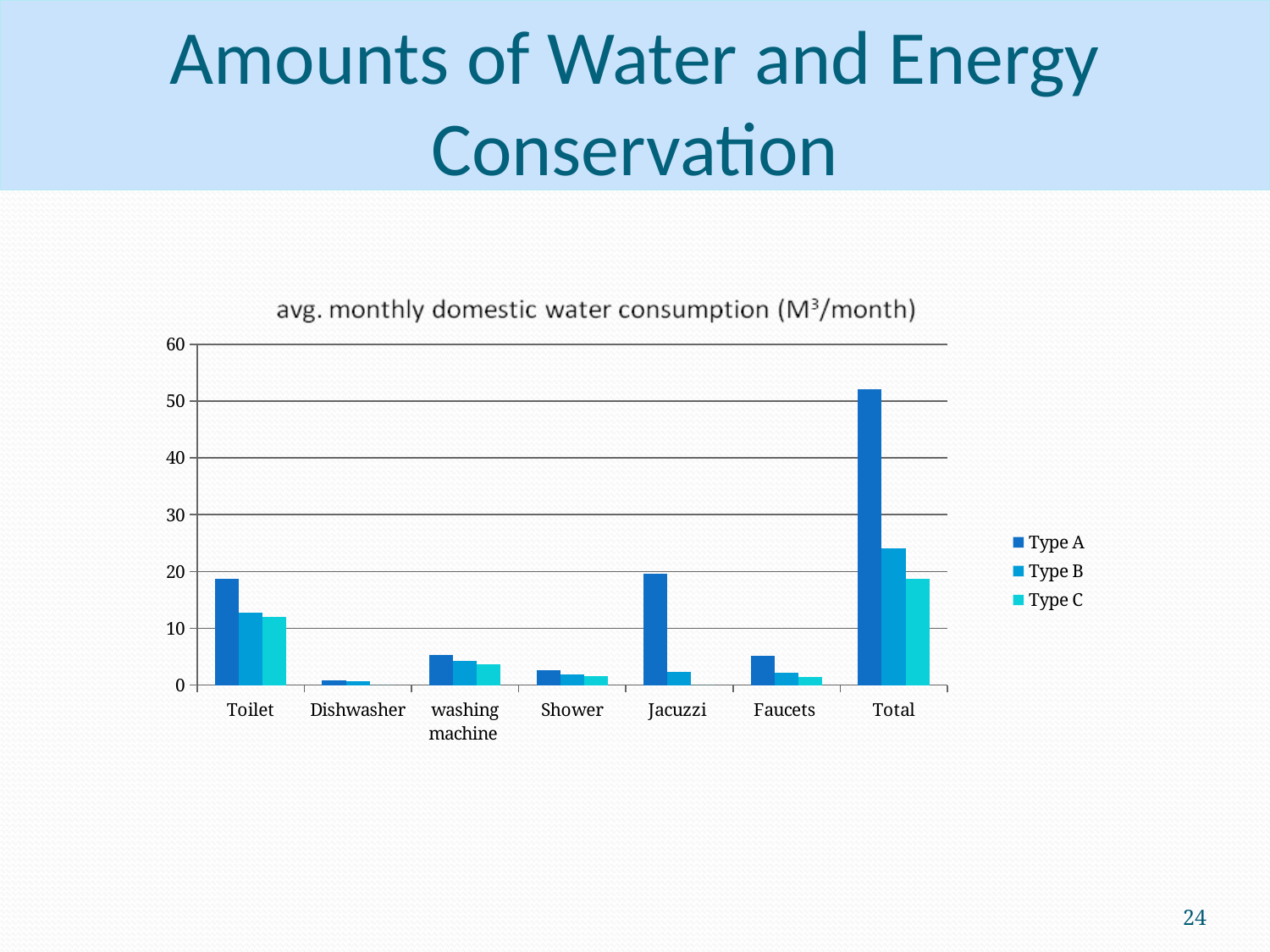
Is the Type A value for Toilet greater or less than 20? less Which category has the lowest Type A value? Dishwasher How many categories are shown on the x axis of the chart? 7 Which has the larger Type A value: Toilet or Faucets? Toilet Is the Type A value for Total greater or less than 50? greater For the Total category, which is larger: the Type B value or the Type C value? Type B What kind of chart is shown on the slide? bar chart Is the Type A value for Jacuzzi greater or less than 10? greater How many series does the chart's legend list? 3 What is the title of the chart? avg. monthly domestic water consumption (M³/month) Which category has the highest Type A value? Total